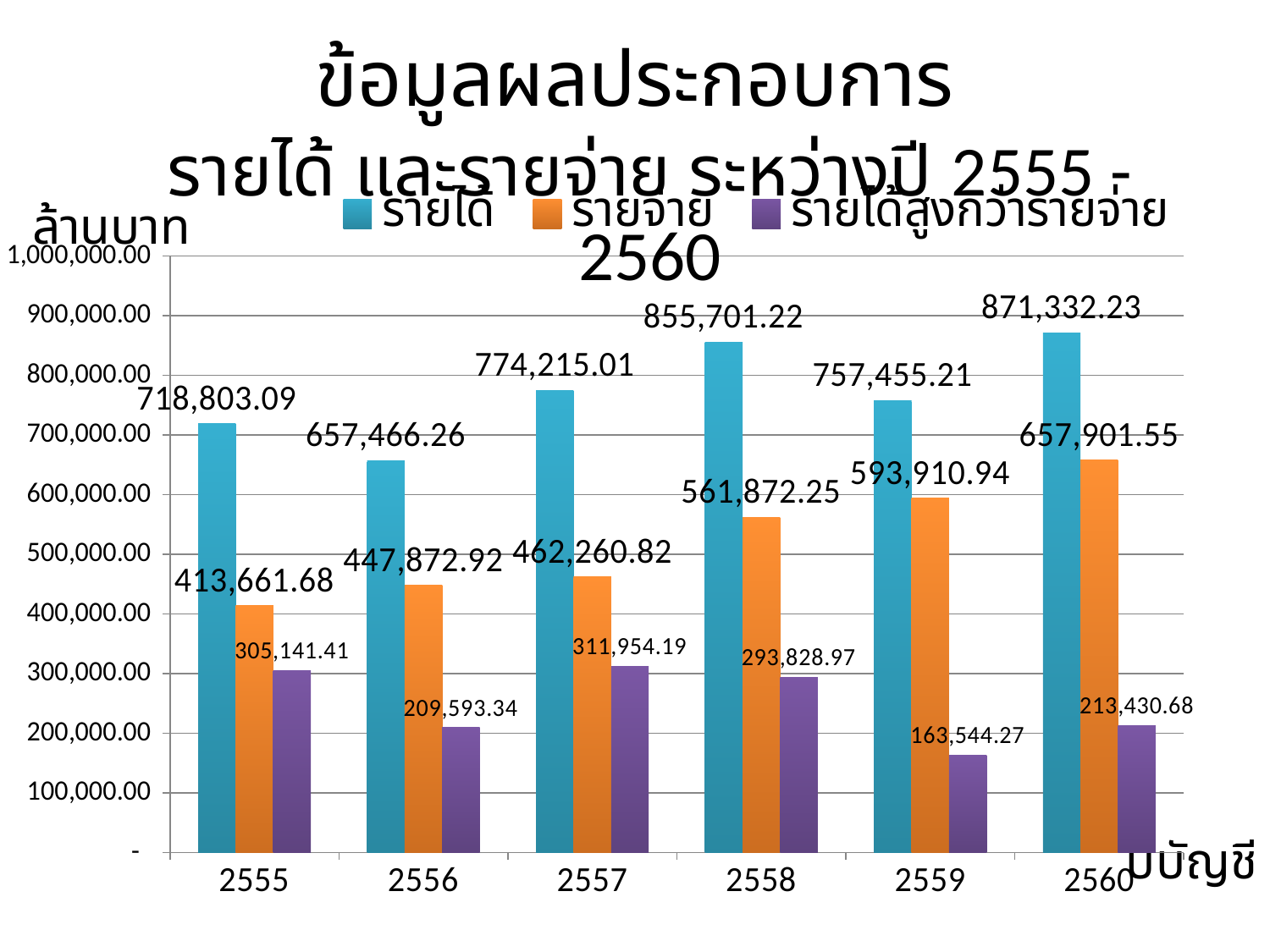
What is the value of รายได้ for 2558? 855,701.22 Which year has the lowest รายจ่าย? 2555 What kind of chart is shown on the slide? Bar chart How many years are shown on the x axis? 6 What is the value of รายจ่าย for 2556? 447,872.92 Which year has the lowest รายได้สูงกว่ารายจ่าย? 2559 What is the value of รายได้สูงกว่ารายจ่าย for 2559? 163,544.27 Does รายจ่าย rise or fall from 2555 to 2560? Rise What is the difference between รายได้ and รายจ่าย in 2560? 213,430.68 How many series does the legend list? 3 Which is larger, รายจ่าย in 2559 or รายจ่าย in 2558? รายจ่าย in 2559 Which year has the highest รายได้? 2560